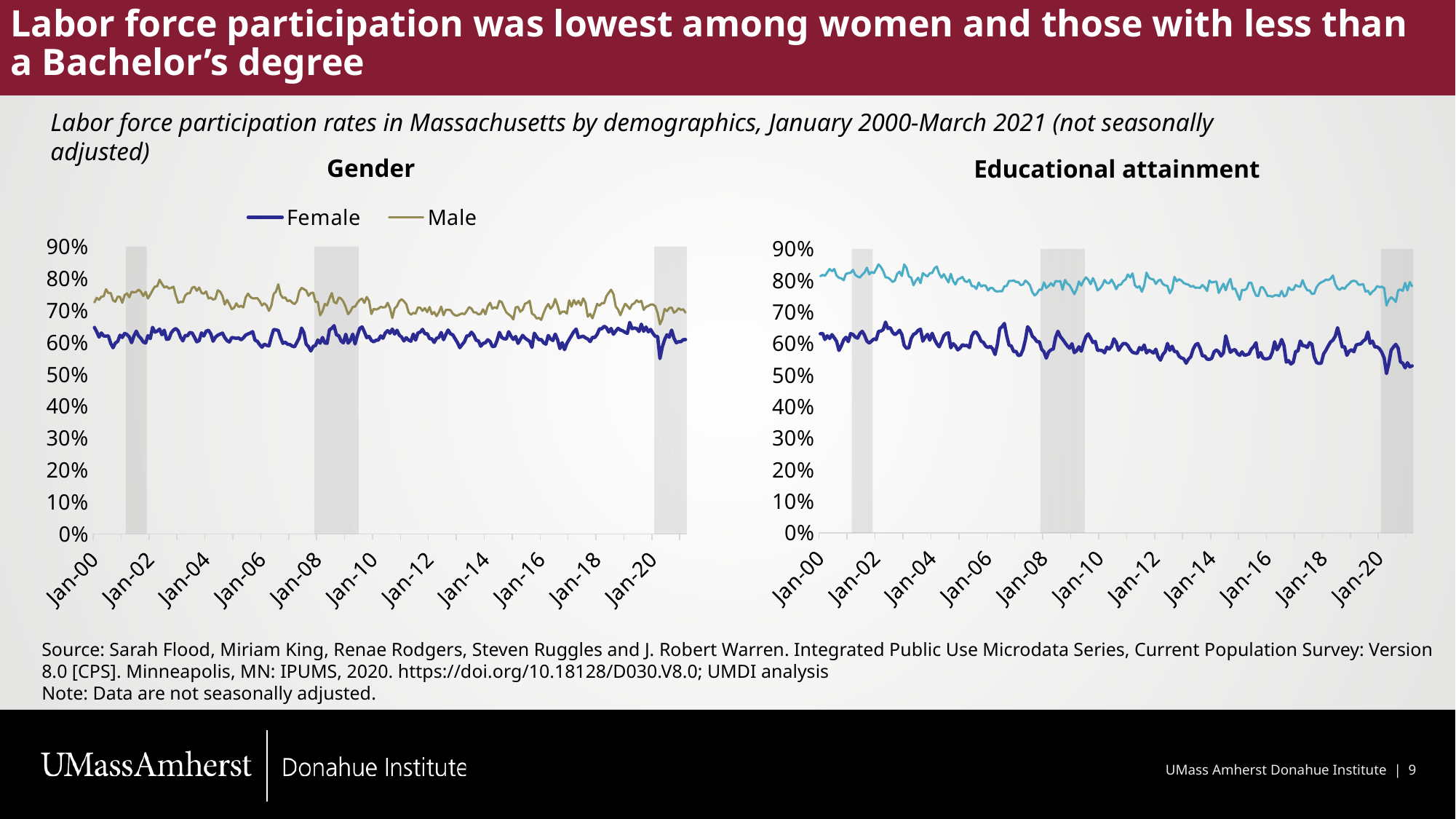
In the Gender chart, is the Male participation rate in Jan-02 greater or less than 70%? greater What is the title of the chart on the right side of the slide? Educational attainment In the Gender chart, is the Female participation rate in Jan-00 greater or less than 70%? less How many year labels are shown on the x axis of the Gender chart? 11 In the Gender chart, does the Male participation rate generally rise or fall from Jan-00 to Jan-20? fall In the Gender chart, is the Female participation rate in Jan-10 greater or less than 50%? greater How many series does the legend of the Gender chart list? 2 What kind of chart is the Gender chart? Line chart In the Educational attainment chart, does the lower (dark blue) line generally rise or fall from Jan-00 to Jan-20? fall In the Gender chart, which series has the higher labor force participation rate throughout the period, Female or Male? Male Which two series are listed in the legend of the Gender chart? Female and Male